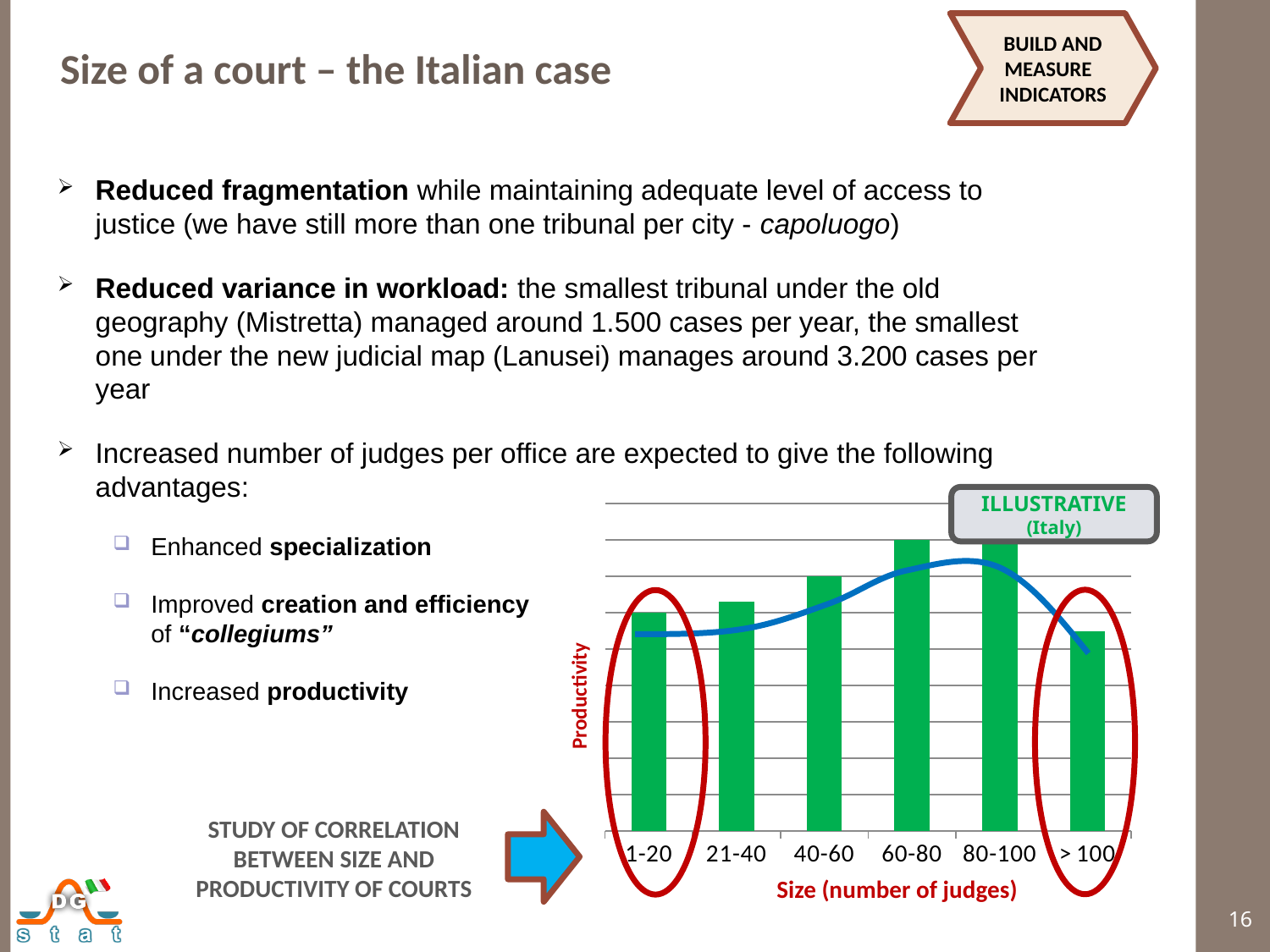
What kind of chart is shown on the slide? Bar chart Does productivity rise or fall from the 80-100 category to the > 100 category? Fall What is the first size category shown on the x axis of the chart? 1-20 How many size categories are shown on the x axis of the chart? 6 What is the label of the y axis of the chart? Productivity Which size category has the lowest productivity bar? > 100 Is the productivity bar for > 100 higher or lower than the bar for 80-100? Lower Is the productivity bar for 60-80 higher or lower than the bar for 1-20? Higher Do the productivity bars rise or fall from the 1-20 category to the 60-80 category? Rise Is the productivity bar for 40-60 higher or lower than the bar for 21-40? Higher What is the label of the x axis of the chart? Size (number of judges) What is the last size category shown on the x axis of the chart? > 100